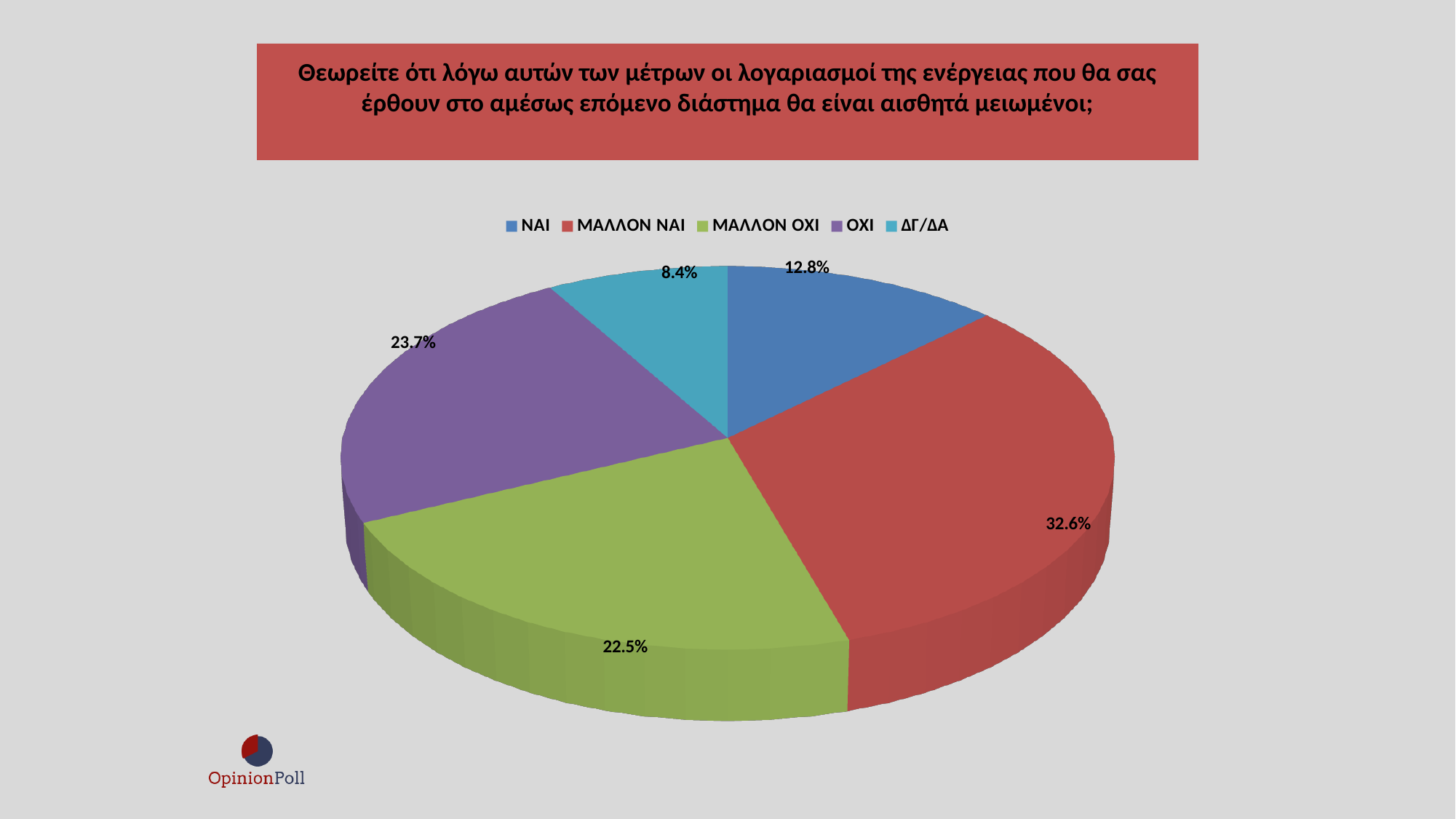
Which is larger, the ΟΧΙ slice or the ΜΑΛΛΟΝ ΟΧΙ slice? ΟΧΙ What is the value shown for ΝΑΙ? 12.8% How many entries does the legend list? 5 What kind of chart is shown on the slide? Pie chart What is the value shown for ΟΧΙ? 23.7% What share of the pie does ΜΑΛΛΟΝ ΝΑΙ hold? 32.6% Which category has the largest slice of the pie? ΜΑΛΛΟΝ ΝΑΙ What is the difference between the ΜΑΛΛΟΝ ΝΑΙ and ΜΑΛΛΟΝ ΟΧΙ slices? 10.1% What is the value shown for ΔΓ/ΔΑ? 8.4% What colour is the ΜΑΛΛΟΝ ΟΧΙ slice? Green Which category has the smallest slice of the pie? ΔΓ/ΔΑ How many slices does the pie chart have? 5